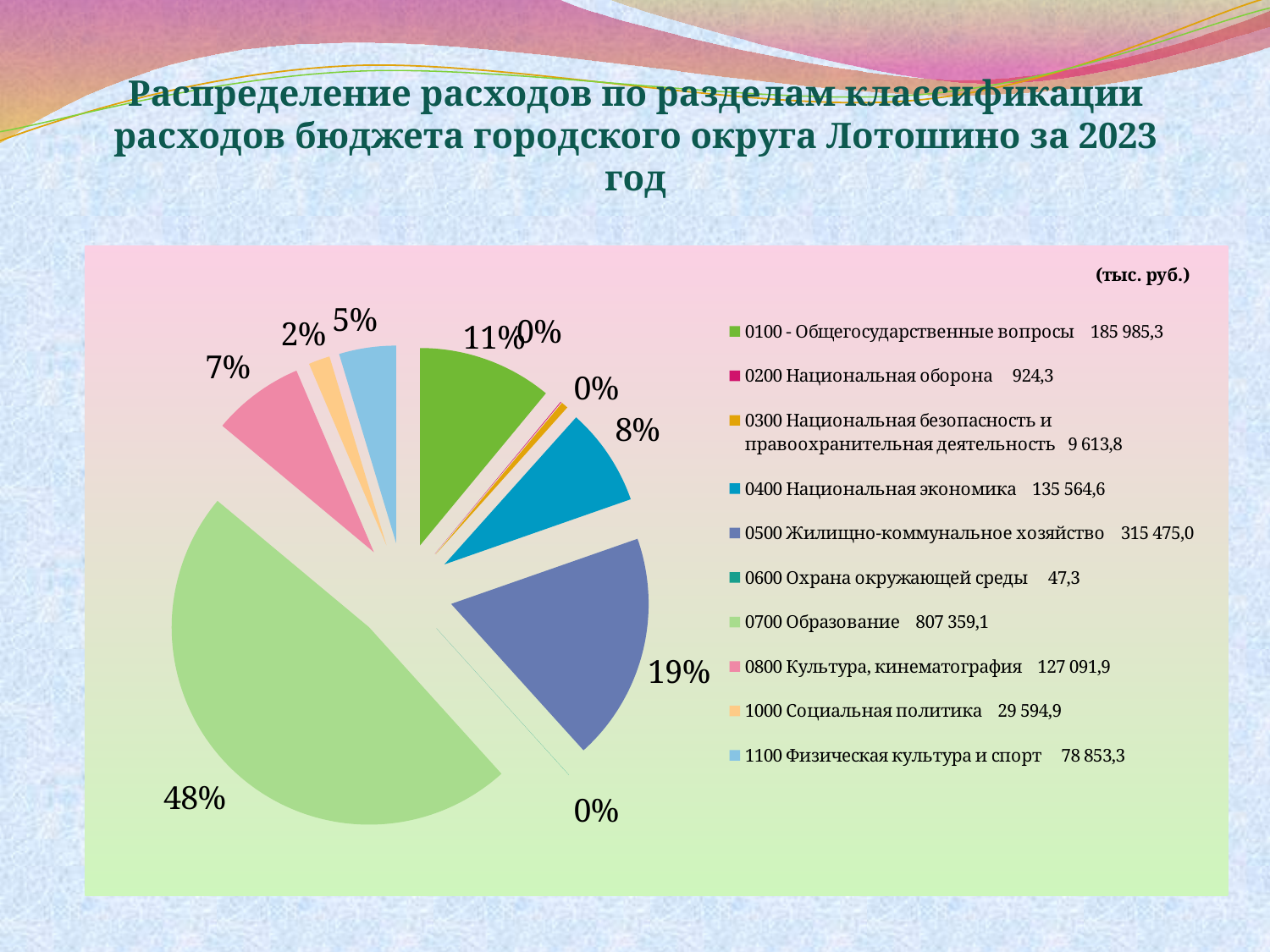
What unit is indicated for the values in the chart? тыс. руб. What is the value shown for 0200 Национальная оборона? 924,3 What is the difference between the values for 0500 Жилищно-коммунальное хозяйство and 0100 Общегосударственные вопросы? 129 489,7 Which is larger: 0100 Общегосударственные вопросы or 0400 Национальная экономика? 0100 Общегосударственные вопросы Which category has the largest value in the pie chart? 0700 Образование How many categories does the legend of the pie chart list? 10 What is the value shown for 0500 Жилищно-коммунальное хозяйство? 315 475,0 What share of the pie does 0500 Жилищно-коммунальное хозяйство take? 19% Which category has the smallest value in the pie chart? 0600 Охрана окружающей среды What is the value shown for 0800 Культура, кинематография? 127 091,9 What share of the pie does 0700 Образование take? 48% What kind of chart is shown on the slide? pie chart